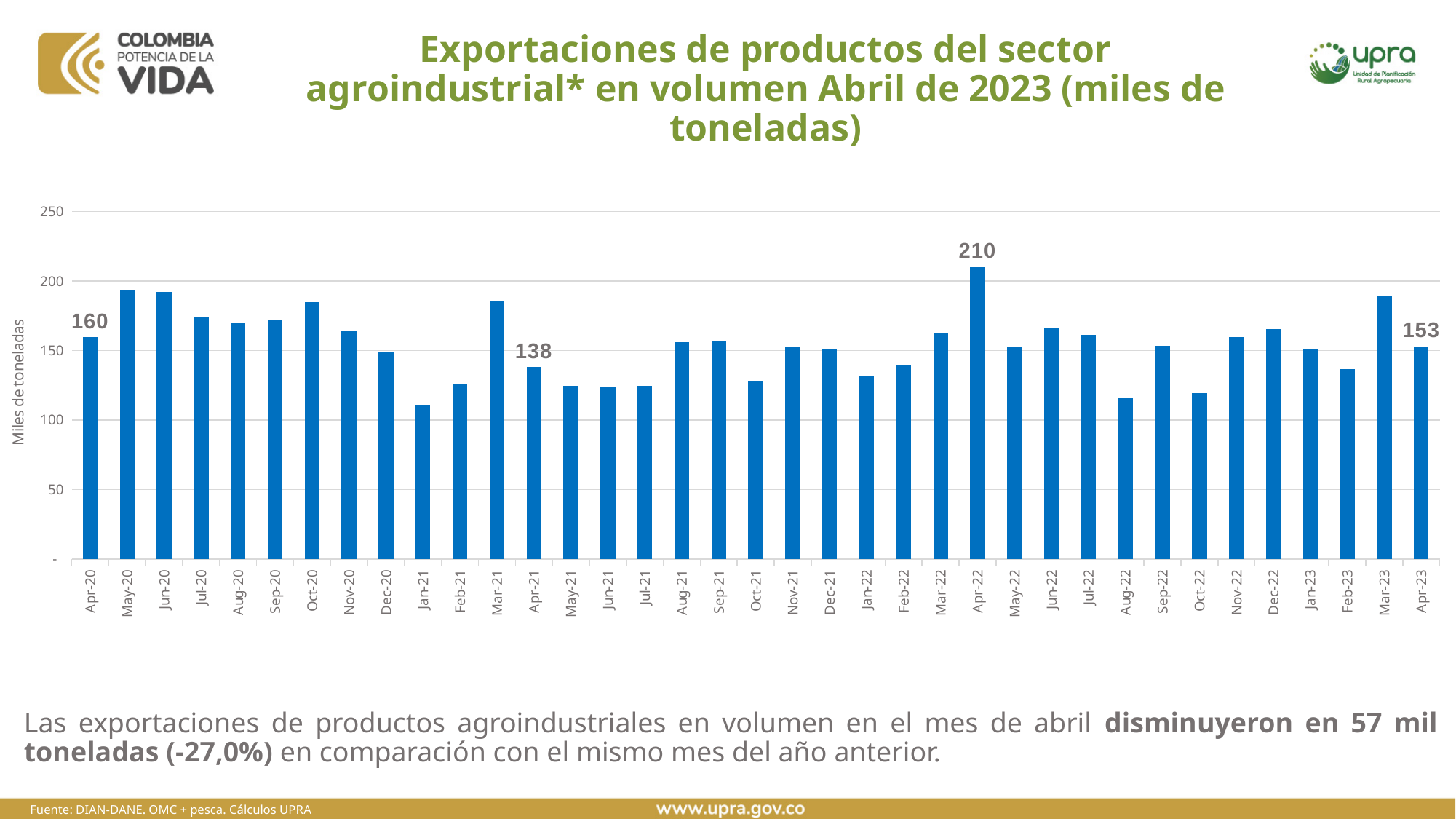
What is the value for Apr-20? 160 Is the value for May-20 greater or less than 150? greater Which month has the highest value in the chart? Apr-22 What is the value for Apr-21? 138 What is the difference between the values for Apr-20 and Apr-21? 22 What type of chart is shown on the slide? Bar chart What is the value for Apr-22? 210 What is the label of the vertical axis? Miles de toneladas What is the value for Apr-23? 153 Which is larger, the value for Apr-20 or the value for Apr-21? Apr-20 What is the difference between the values for Apr-22 and Apr-23? 57 Is the value for Jan-21 greater or less than 150? less